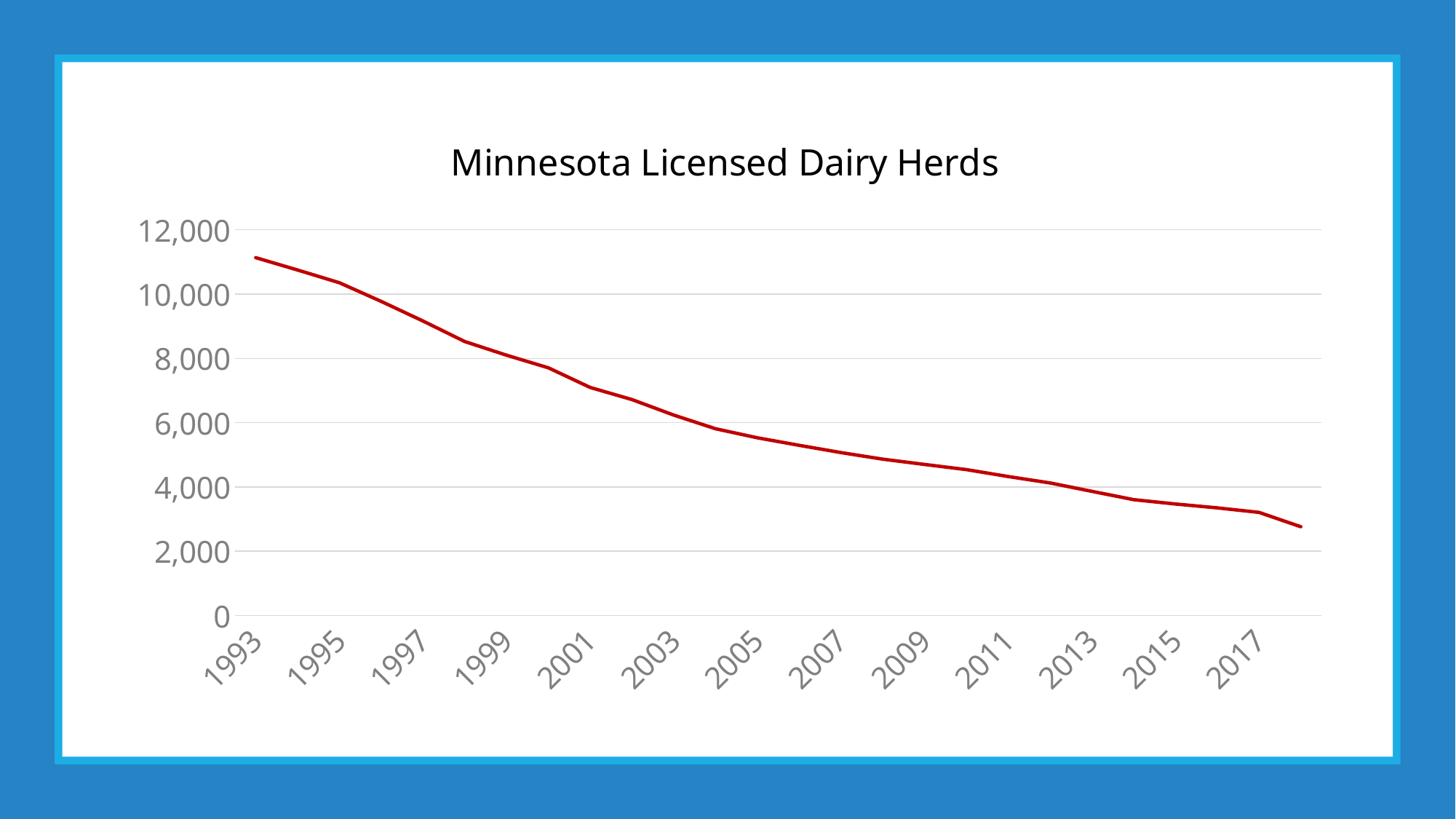
What kind of chart is shown on the slide? line chart Do the values rise or fall from 1993 to 2017? fall Is the value for 2017 greater or less than 2,000? greater Is the value for 2015 greater or less than 4,000? less Which year labeled on the x axis has the highest value? 1993 Is the value for 2001 greater or less than 8,000? less What is the title of the chart? Minnesota Licensed Dairy Herds Which is larger, the value for 1993 or the value for 2017? 1993